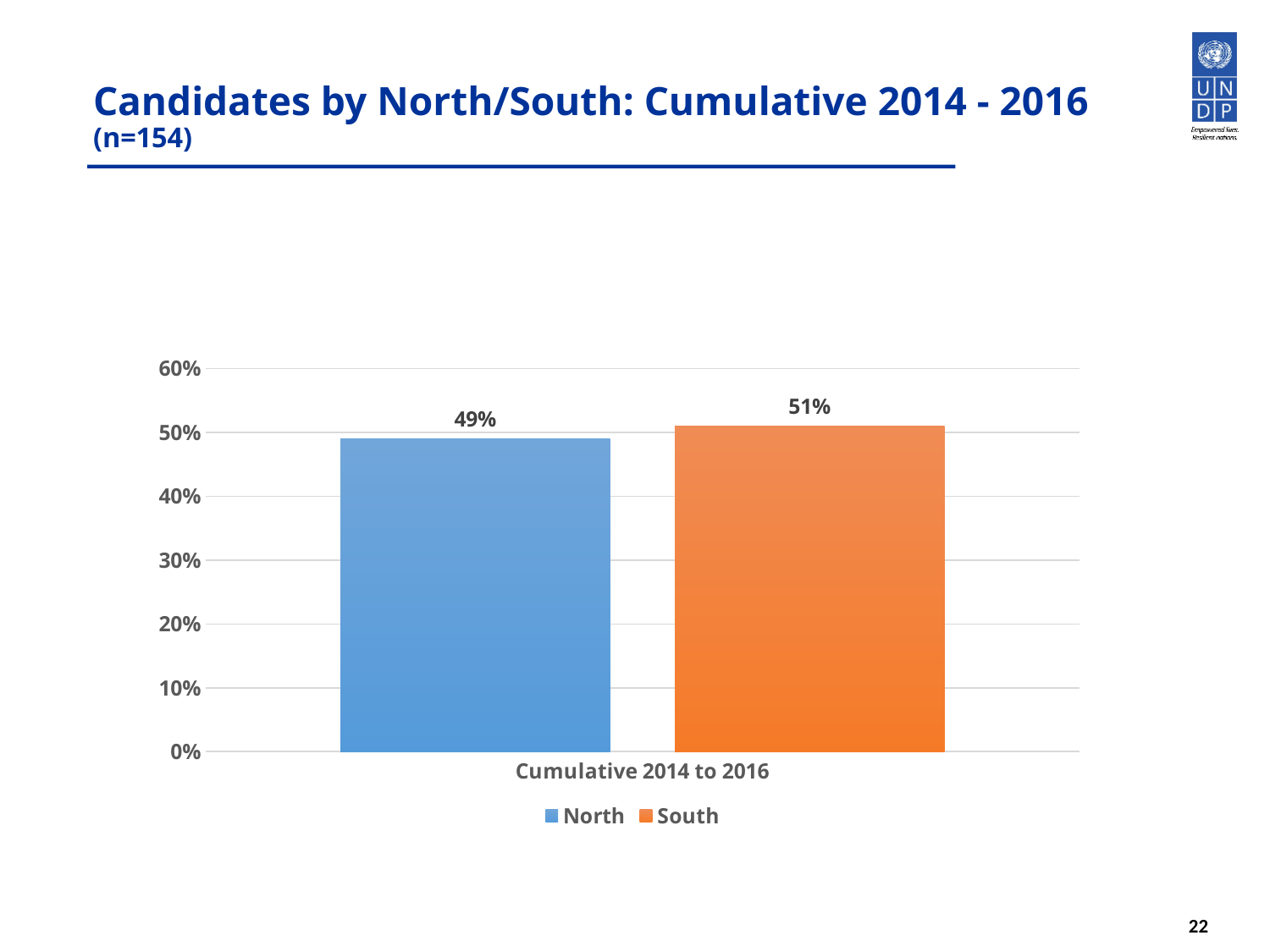
How many series does the legend list? 2 Which series has the lower value, North or South? North What percentage of candidates are from the South? 51% What is the sample size (n) stated in the slide title? 154 What is the label on the x axis of the chart? Cumulative 2014 to 2016 What percentage of candidates are from the North? 49% Is the value for South greater or less than 50%? greater What colour is the bar for South? orange What kind of chart is shown on the slide? bar chart What is the difference between the South and North percentages? 2% Which series has the higher value, North or South? South Is the value for North greater or less than 50%? less